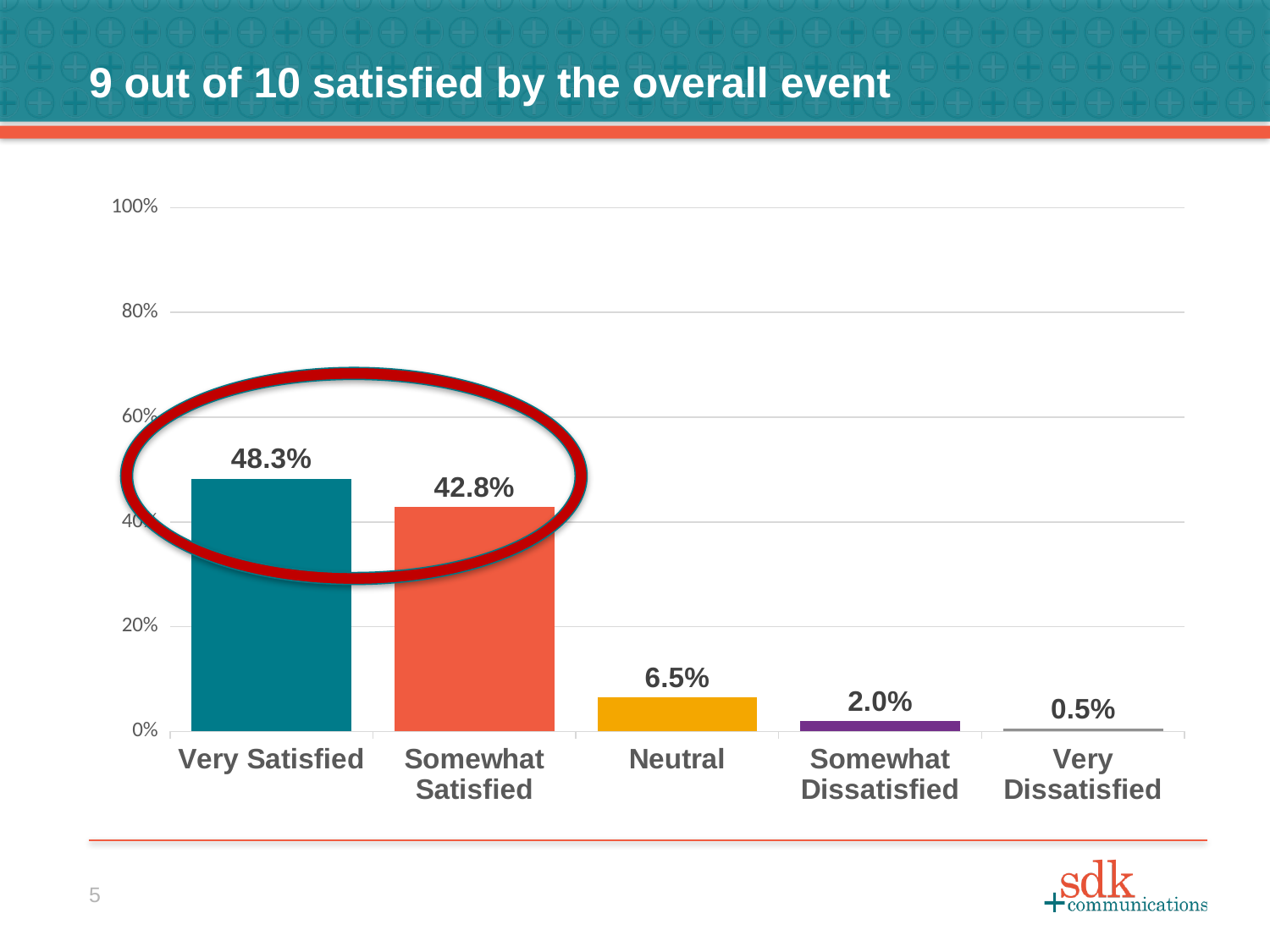
Which is larger, the value for Neutral or the value for Somewhat Dissatisfied? Neutral Which category has the highest value? Very Satisfied What is the title of the slide? 9 out of 10 satisfied by the overall event What is the value for Very Satisfied? 48.3% What is the value for Very Dissatisfied? 0.5% Which category has the lowest value? Very Dissatisfied How many categories are shown on the x axis? 5 What is the difference between the values for Very Satisfied and Somewhat Satisfied? 5.5% What is the value for Somewhat Satisfied? 42.8% Is the value for Very Satisfied greater or less than 40%? greater What is the value for Neutral? 6.5% What kind of chart is shown on the slide? bar chart